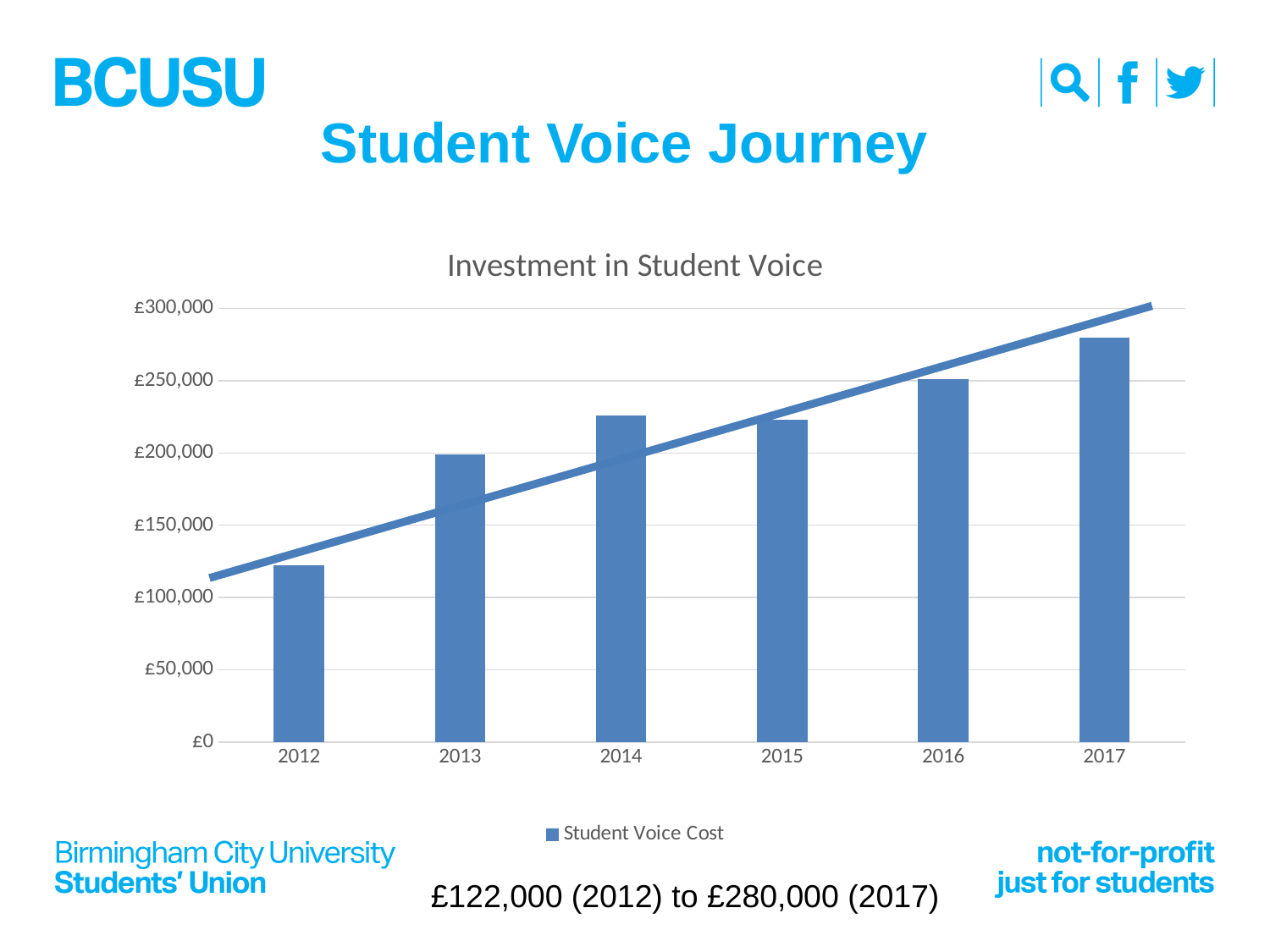
What is the Student Voice Cost for 2012? £122,000 Which year has the larger Student Voice Cost, 2013 or 2016? 2016 Which year has the highest Student Voice Cost? 2017 What kind of chart is used to show the Student Voice Cost? bar chart What is the title of the chart? Investment in Student Voice How many years are shown on the x axis of the chart? 6 How many series does the chart legend list? 1 Is the Student Voice Cost for 2014 greater or less than £200,000? greater What is the Student Voice Cost for 2017? £280,000 Which year has the lowest Student Voice Cost? 2012 Does the Student Voice Cost generally rise or fall from 2012 to 2017? rise By how much did the Student Voice Cost increase from 2012 to 2017? £158,000